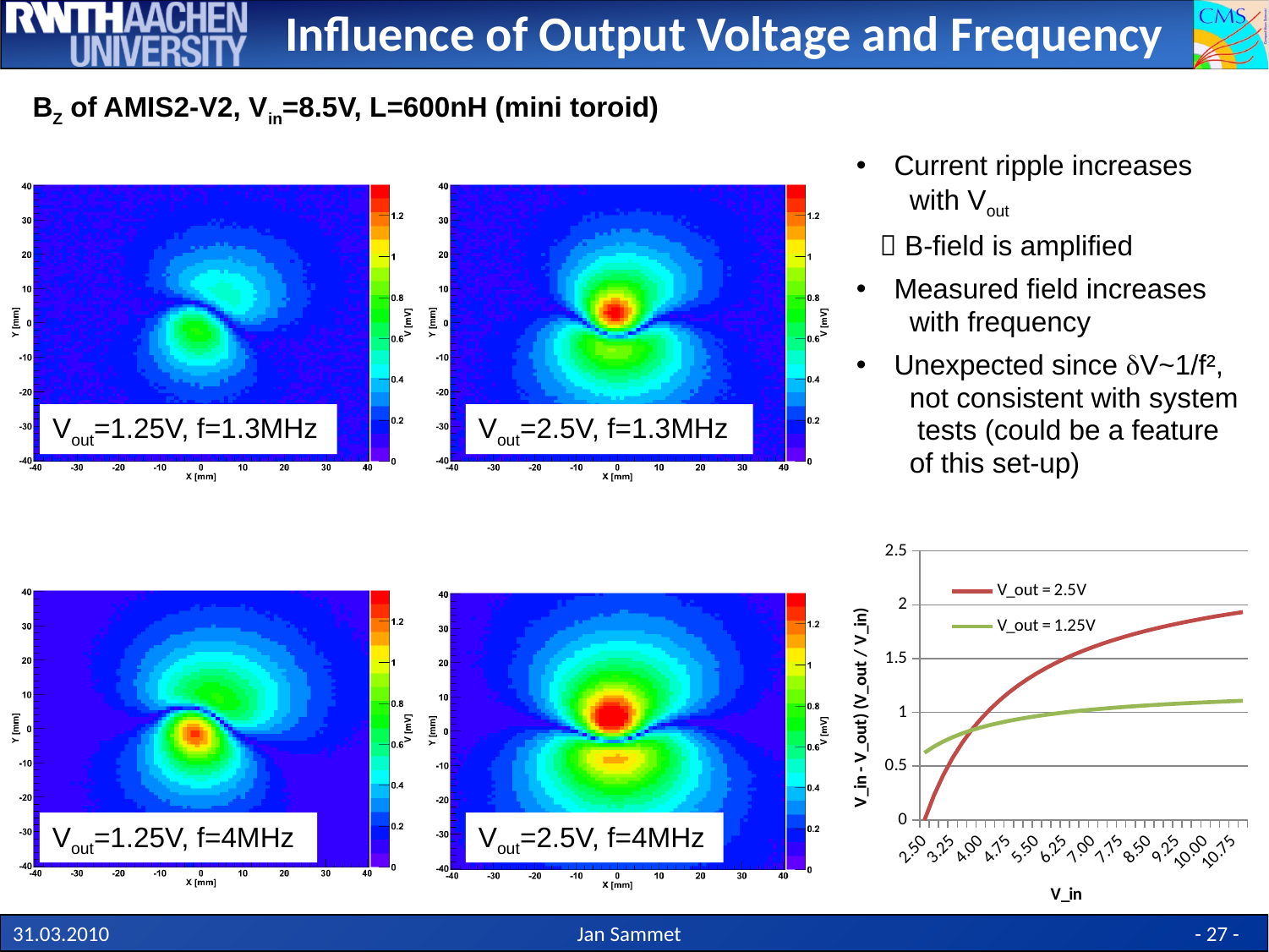
On the line chart at the bottom right, which series has the larger value at V_in = 2.50, V_out = 2.5V or V_out = 1.25V? V_out = 1.25V On the line chart at the bottom right, does the V_out = 2.5V series rise or fall as V_in increases? rise On the line chart at the bottom right, is the value of the V_out = 2.5V series at V_in = 2.50 greater or less than 0.5? less On the line chart at the bottom right, how many labelled tick marks are on the x axis? 12 On the line chart at the bottom right, is the value of the V_out = 2.5V series at V_in = 10.75 greater or less than 1.5? greater On the line chart at the bottom right, what is the label of the x axis? V_in On the line chart at the bottom right, which series has the larger value at V_in = 10.75, V_out = 2.5V or V_out = 1.25V? V_out = 2.5V On the line chart at the bottom right, what colour is the line for V_out = 2.5V? red What kind of chart is the chart at the bottom right of the slide? line chart On the line chart at the bottom right, is the value of the V_out = 1.25V series at V_in = 10.75 greater or less than 1.5? less On the line chart at the bottom right, how many series does the legend list? 2 On the line chart at the bottom right, does the V_out = 1.25V series rise or fall as V_in increases? rise